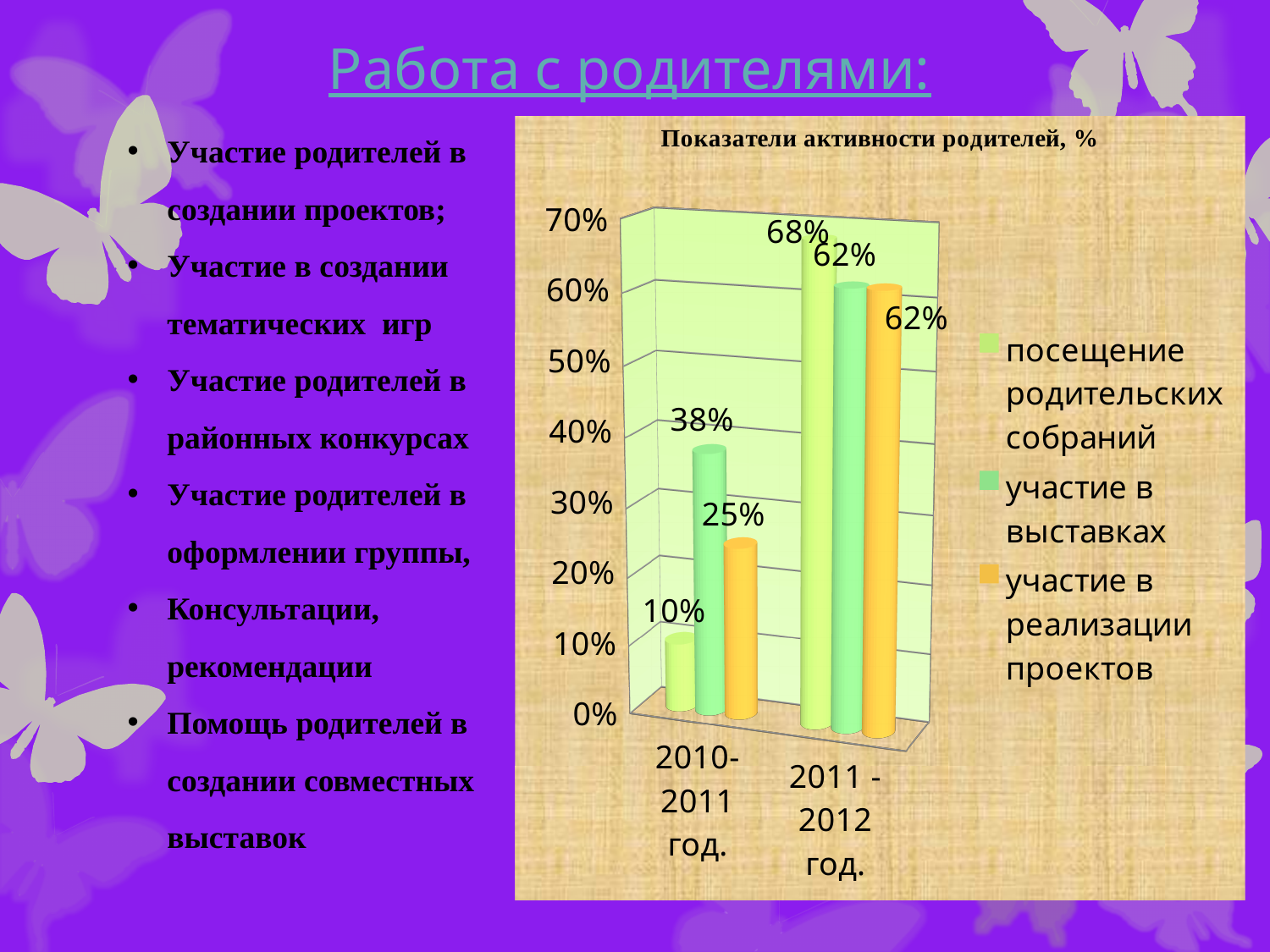
How many series does the legend list? 3 What is the difference between участие в выставках in 2011 - 2012 год. and in 2010-2011 год.? 24% Which series has the lowest value in 2010-2011 год.? посещение родительских собраний What kind of chart is shown on the slide? bar chart How many categories are shown on the x axis? 2 What is the title of the chart? Показатели активности родителей, % What is the value for участие в выставках in 2010-2011 год.? 38% Which is larger in 2010-2011 год.: участие в выставках or участие в реализации проектов? участие в выставках What is the value for посещение родительских собраний in 2010-2011 год.? 10% What is the value for участие в реализации проектов in 2011 - 2012 год.? 62% What is the value for посещение родительских собраний in 2011 - 2012 год.? 68% Which series has the highest value in 2011 - 2012 год.? посещение родительских собраний